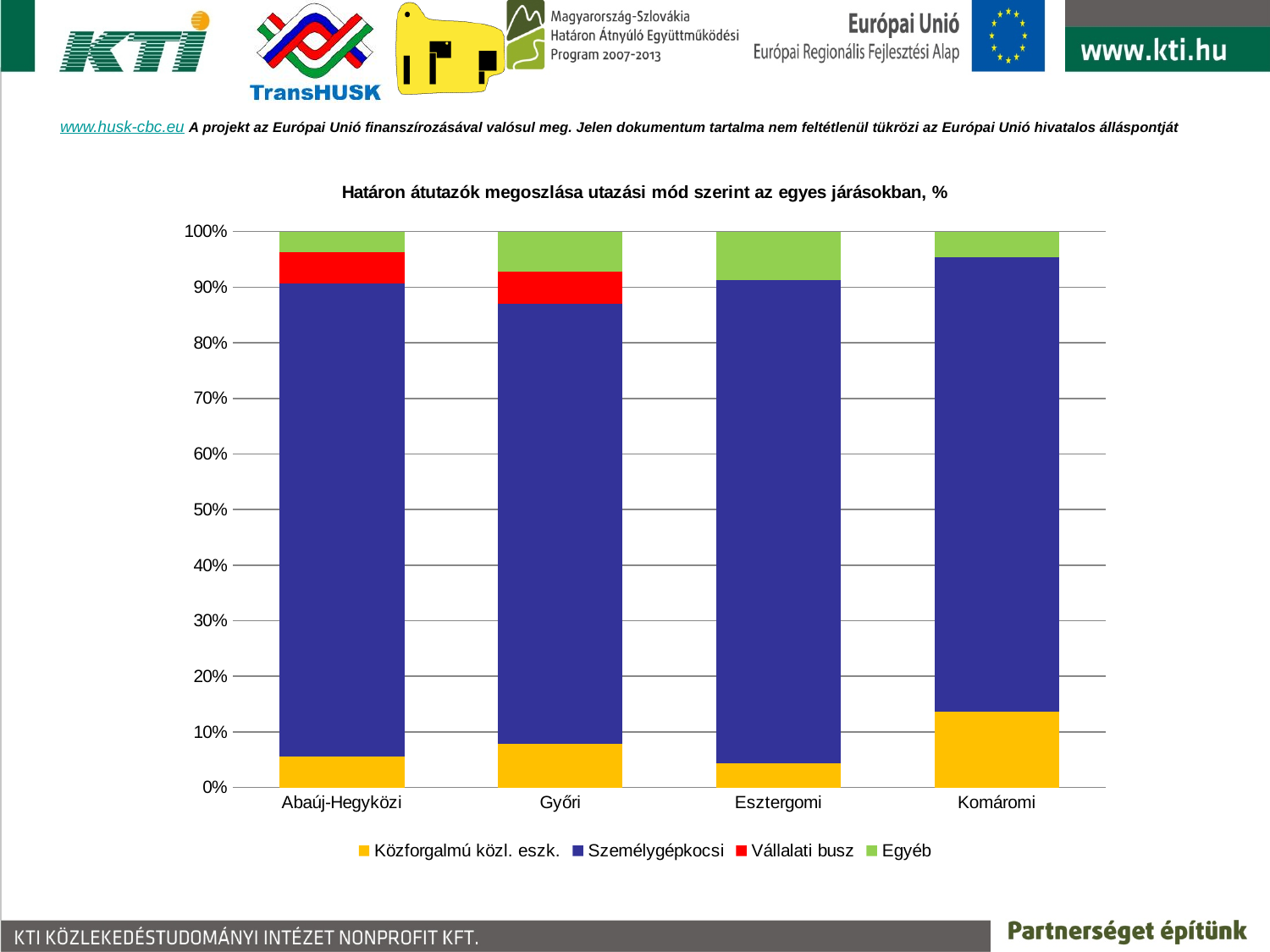
What kind of chart is shown on the slide? Stacked bar chart Is the Közforgalmú közl. eszk. share for Abaúj-Hegyközi greater or less than 10%? less Which districts have no Vállalati busz segment in their bar? Esztergomi and Komáromi Which district has the largest share of Közforgalmú közl. eszk.? Komáromi What is the title of the chart? Határon átutazók megoszlása utazási mód szerint az egyes járásokban, % Is the Közforgalmú közl. eszk. share for Komáromi greater or less than 10%? greater Which is larger, the Közforgalmú közl. eszk. share for Komáromi or for Győri? Komáromi What is the total height of the stacked bar for Esztergomi? 100% How many series does the legend list? 4 How many districts (categories) are shown on the x axis? 4 Is the Közforgalmú közl. eszk. share for Győri greater or less than 10%? less Which is larger, the Személygépkocsi share for Komáromi or for Győri? Komáromi